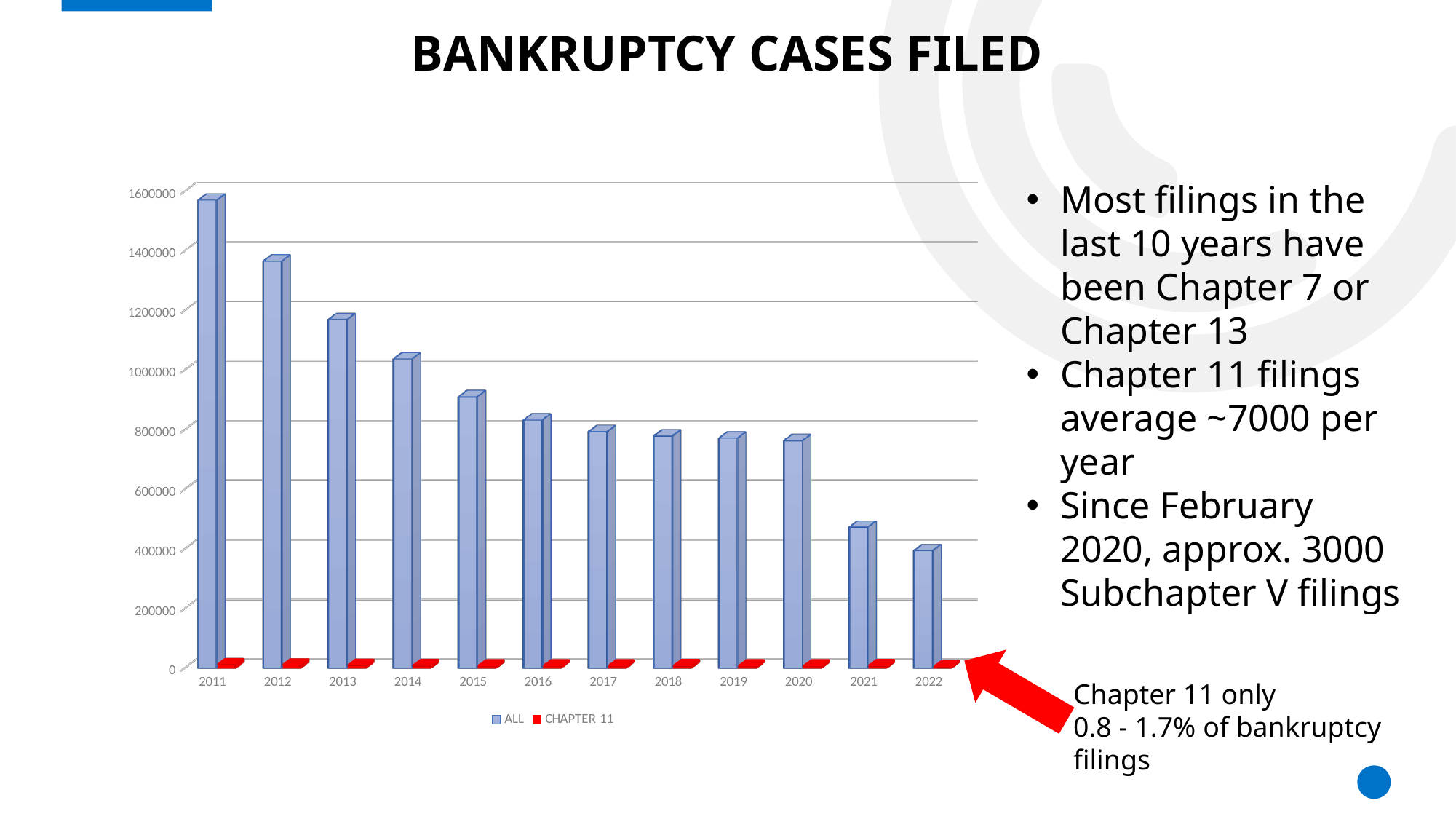
Do the values for the ALL series rise or fall from 2011 to 2022? fall Which year has the highest value for the ALL series? 2011 How many series does the chart legend list? 2 Is the ALL value for 2011 greater or less than 1400000? greater Which is larger, the ALL value for 2011 or the ALL value for 2022? 2011 What colour are the bars for the CHAPTER 11 series? red Is the ALL value for 2021 greater or less than 400000? greater What kind of chart is shown on the slide? bar chart How many years are shown on the x axis of the chart? 12 Which year has the lowest value for the ALL series? 2022 Is the ALL value for 2020 greater or less than 800000? less